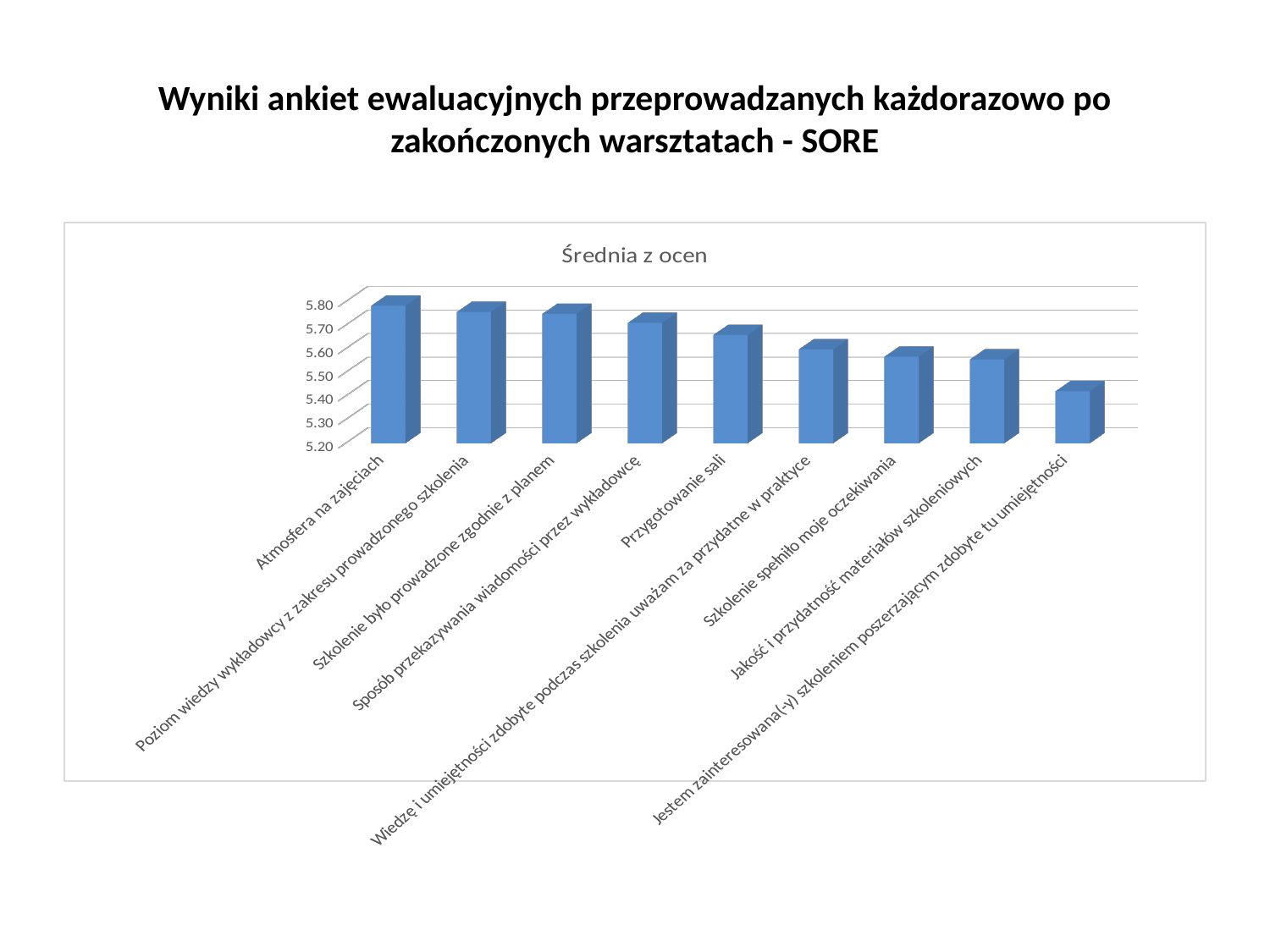
Is the value for Jestem zainteresowana(-y) szkoleniem poszerzającym zdobyte tu umiejętności greater or less than 5.50? less Is the value for Przygotowanie sali greater or less than 5.60? greater Which category has the lowest value? Jestem zainteresowana(-y) szkoleniem poszerzającym zdobyte tu umiejętności Is the value for Atmosfera na zajęciach greater or less than 5.70? greater Which category has the highest value? Atmosfera na zajęciach Which is larger: the value for Przygotowanie sali or the value for Jakość i przydatność materiałów szkoleniowych? Przygotowanie sali Which is larger: the value for Atmosfera na zajęciach or the value for Szkolenie spełniło moje oczekiwania? Atmosfera na zajęciach What is the title of the chart? Średnia z ocen What kind of chart is shown on the slide? bar chart How many categories are plotted in the chart? 9 Do the values rise or fall from left to right along the x axis? fall